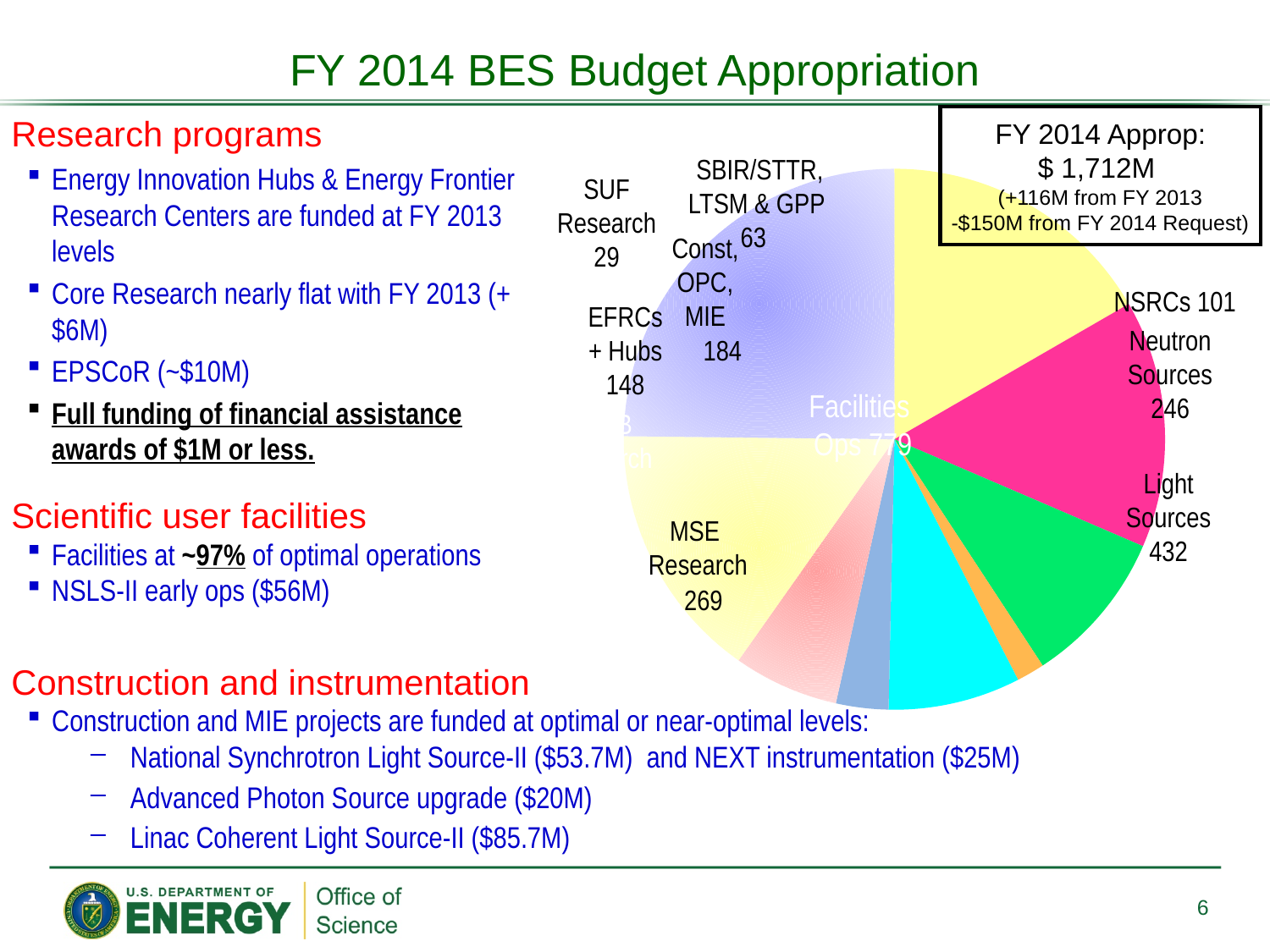
Which labelled slice of the pie chart has the smallest value? SUF Research What is the difference between the Light Sources value and the Neutron Sources value in the pie chart? 186 What is the value shown for Neutron Sources in the pie chart? 246 What is the value shown for SUF Research in the pie chart? 29 Which is larger in the pie chart, MSE Research or Neutron Sources? MSE Research What is the value shown for NSRCs in the pie chart? 101 What is the value shown for Light Sources in the pie chart? 432 What is the value shown for MSE Research in the pie chart? 269 What is the value shown for Const, OPC, MIE in the pie chart? 184 What is the value shown for EFRCs + Hubs in the pie chart? 148 What kind of chart is shown on the slide? Pie chart